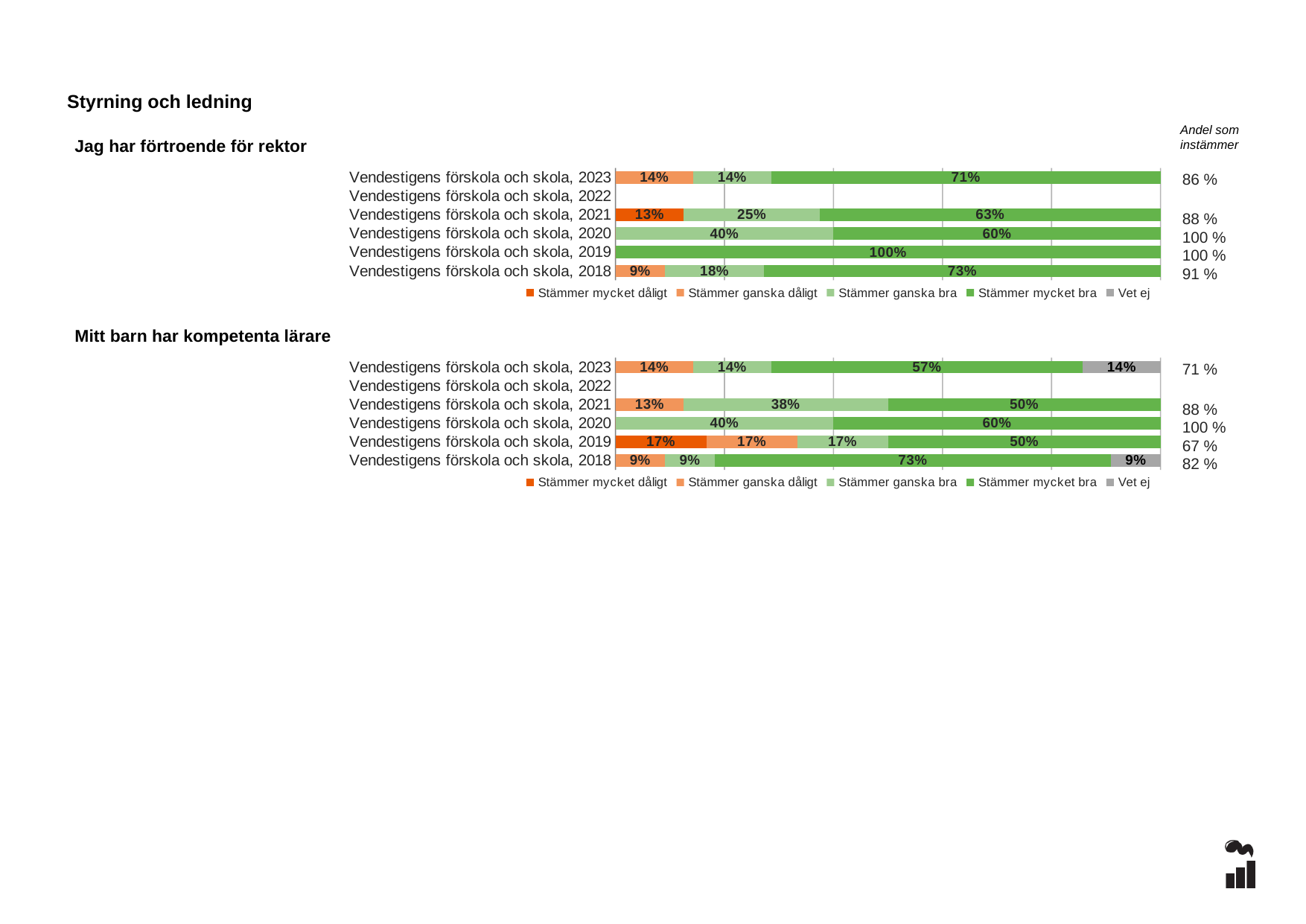
In the chart 'Mitt barn har kompetenta lärare', what is the 'Andel som instämmer' value for Vendestigens förskola och skola, 2019? 67 % How many category rows are listed on the y axis of the chart 'Jag har förtroende för rektor'? 6 In the chart 'Mitt barn har kompetenta lärare', what is the 'Stämmer ganska bra' value for Vendestigens förskola och skola, 2021? 38% In the chart 'Jag har förtroende för rektor', what is the 'Stämmer mycket bra' value for Vendestigens förskola och skola, 2023? 71% In the chart 'Mitt barn har kompetenta lärare', which is larger: the 'Stämmer mycket bra' value for 2018 or for 2019? 2018 In the chart 'Jag har förtroende för rektor', what is the 'Stämmer mycket dåligt' value for Vendestigens förskola och skola, 2021? 13% In the chart 'Mitt barn har kompetenta lärare', which year has the lowest 'Andel som instämmer' value? 2019 In the chart 'Mitt barn har kompetenta lärare', what is the 'Vet ej' value for Vendestigens förskola och skola, 2023? 14% In the chart 'Jag har förtroende för rektor', which year has the highest 'Stämmer mycket bra' value? 2019 How many series does the legend of the chart 'Jag har förtroende för rektor' list? 5 What kind of chart is 'Mitt barn har kompetenta lärare'? Stacked bar chart In the chart 'Jag har förtroende för rektor', what is the difference between the 'Stämmer mycket bra' values for 2018 and 2021? 10%